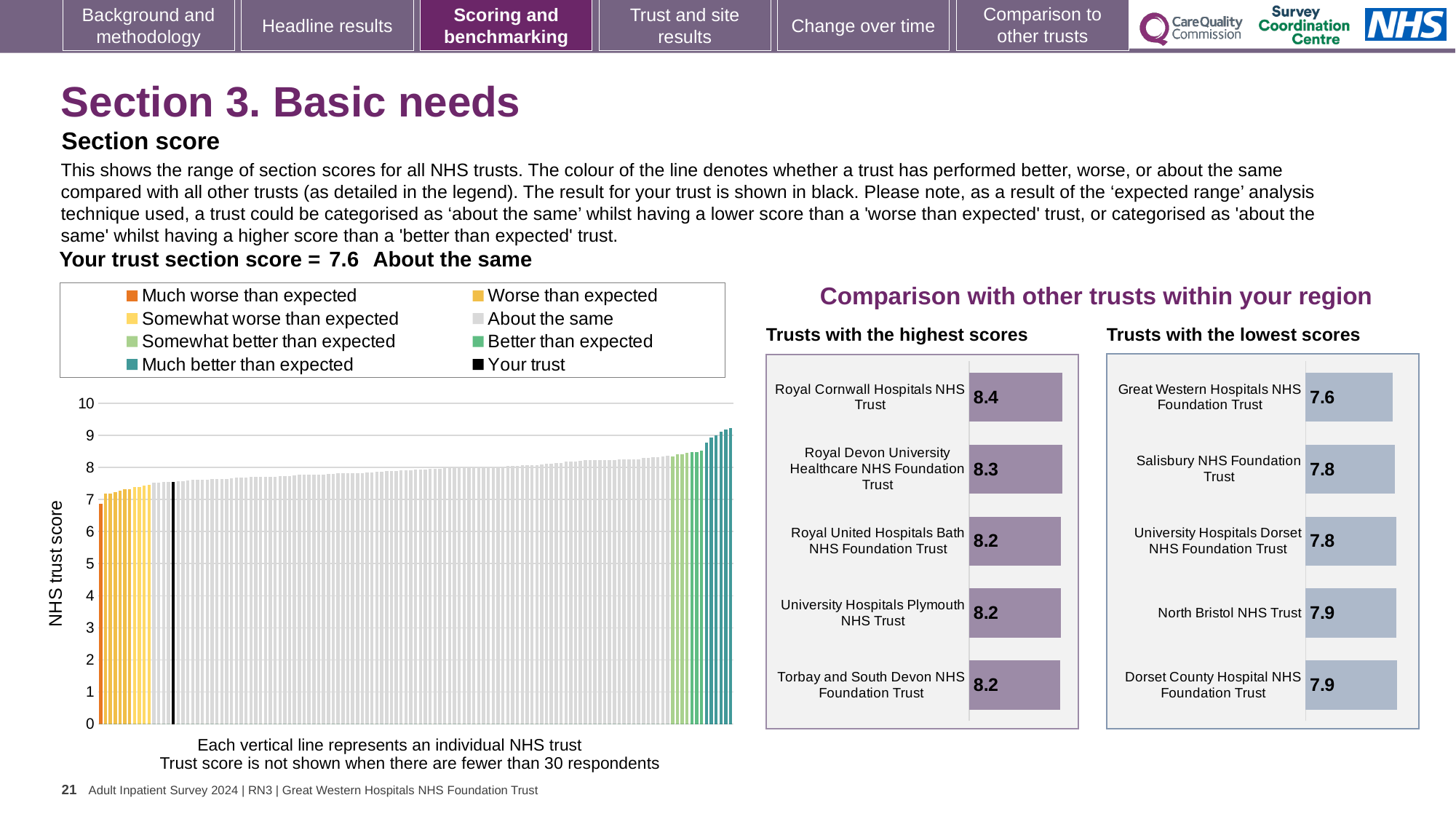
In the 'Trusts with the lowest scores' chart, which trust has the lowest score? Great Western Hospitals NHS Foundation Trust In the 'Trusts with the lowest scores' chart, what is the score for Great Western Hospitals NHS Foundation Trust? 7.6 How many trusts are shown in the 'Trusts with the highest scores' chart? 5 In the 'Trusts with the highest scores' chart, which trust has the highest score? Royal Cornwall Hospitals NHS Trust In the 'Trusts with the lowest scores' chart, which has the larger score: Salisbury NHS Foundation Trust or Dorset County Hospital NHS Foundation Trust? Dorset County Hospital NHS Foundation Trust In the 'Trusts with the highest scores' chart, what is the score for Royal Devon University Healthcare NHS Foundation Trust? 8.3 How many entries does the legend of the main chart on the left list? 8 What kind of chart is the main chart on the left showing the range of section scores for all NHS trusts? bar chart In the main chart on the left showing all NHS trusts, is the value for the black 'Your trust' bar greater or less than 5? greater What is the difference between the score for Royal Cornwall Hospitals NHS Trust in the highest scores chart and the score for Great Western Hospitals NHS Foundation Trust in the lowest scores chart? 0.8 In the 'Trusts with the highest scores' chart, what is the score for Royal Cornwall Hospitals NHS Trust? 8.4 In the 'Trusts with the lowest scores' chart, what is the score for North Bristol NHS Trust? 7.9